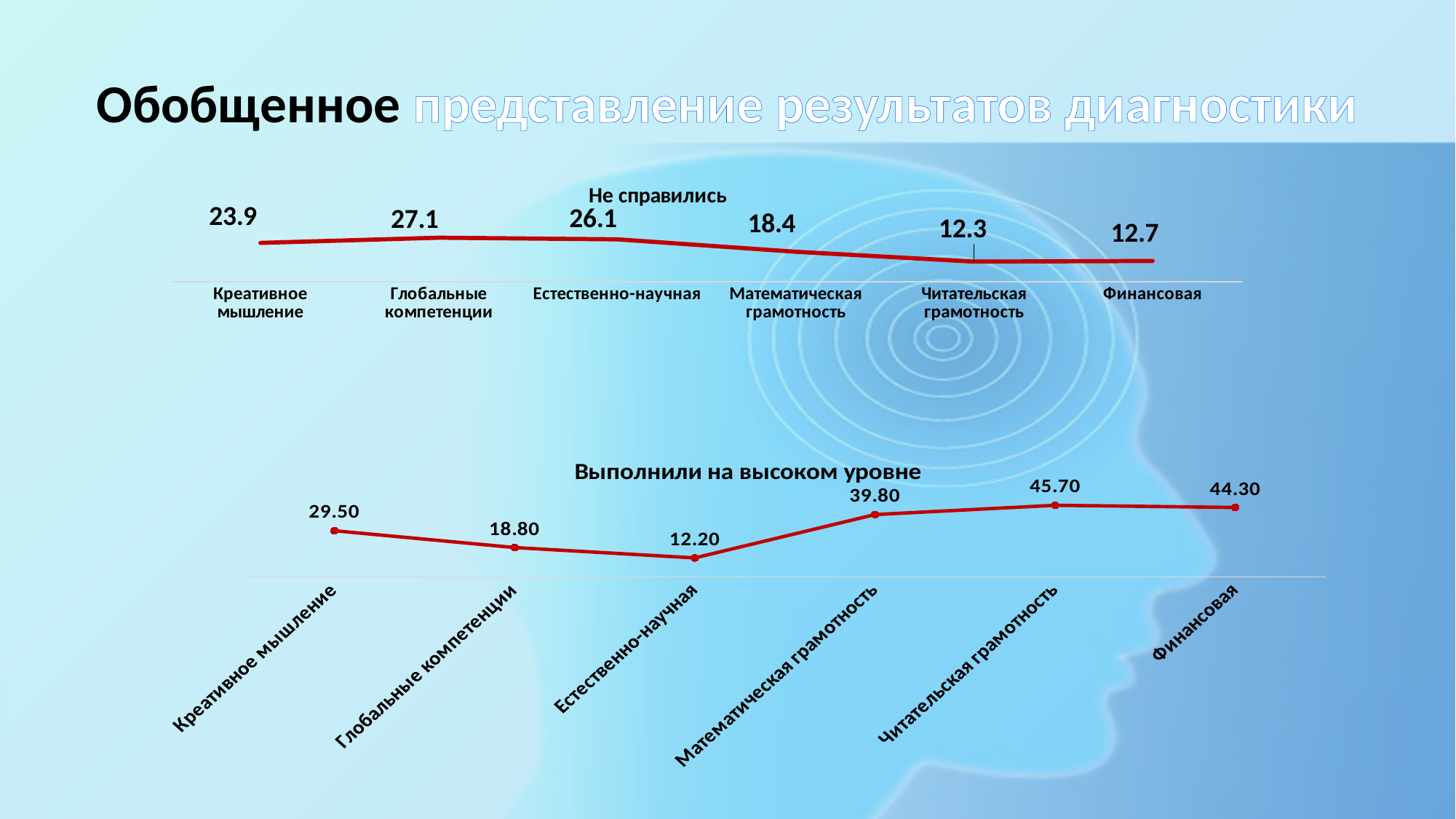
In the chart titled "Выполнили на высоком уровне", which category has the highest value? Читательская грамотность What type of chart is the one titled "Выполнили на высоком уровне"? Line chart In the chart titled "Выполнили на высоком уровне", which category has the lowest value? Естественно-научная In the chart titled "Не справились", do the values generally rise or fall from Естественно-научная to Читательская грамотность? Fall In the chart titled "Не справились", which category has the highest value? Глобальные компетенции In the chart titled "Не справились", what is the value for Глобальные компетенции? 27.1 In the chart titled "Не справились", what is the difference between the values for Креативное мышление and Математическая грамотность? 5.5 In the chart titled "Не справились", which category has the lowest value? Читательская грамотность In the chart titled "Выполнили на высоком уровне", which is larger: the value for Креативное мышление or the value for Глобальные компетенции? Креативное мышление In the chart titled "Не справились", how many categories are plotted? 6 In the chart titled "Выполнили на высоком уровне", what is the value for Математическая грамотность? 39.80 In the chart titled "Выполнили на высоком уровне", what is the difference between the values for Читательская грамотность and Финансовая? 1.40